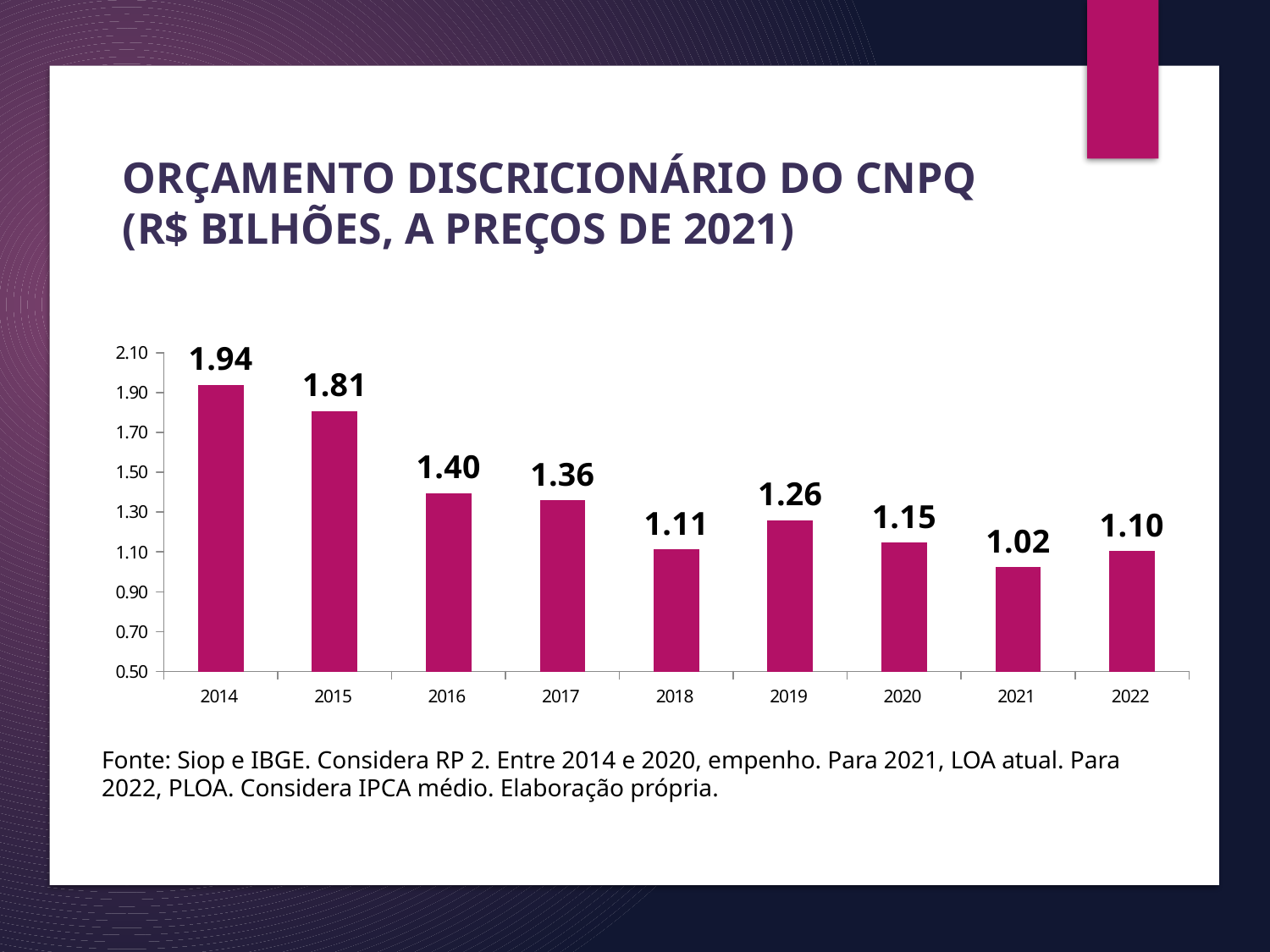
What is the title of the chart? ORÇAMENTO DISCRICIONÁRIO DO CNPQ (R$ BILHÕES, A PREÇOS DE 2021) What is the value for 2022? 1.10 What is the value for 2018? 1.11 What is the difference between the values for 2014 and 2015? 0.13 Which is larger, the value for 2016 or the value for 2019? 2016 Which year has the lowest value? 2021 Is the value for 2017 greater or less than 1.50? less How many years are shown on the x axis? 9 What kind of chart is shown on the slide? bar chart What is the difference between the values for 2019 and 2020? 0.11 Which year has the highest value? 2014 What is the value for 2014? 1.94